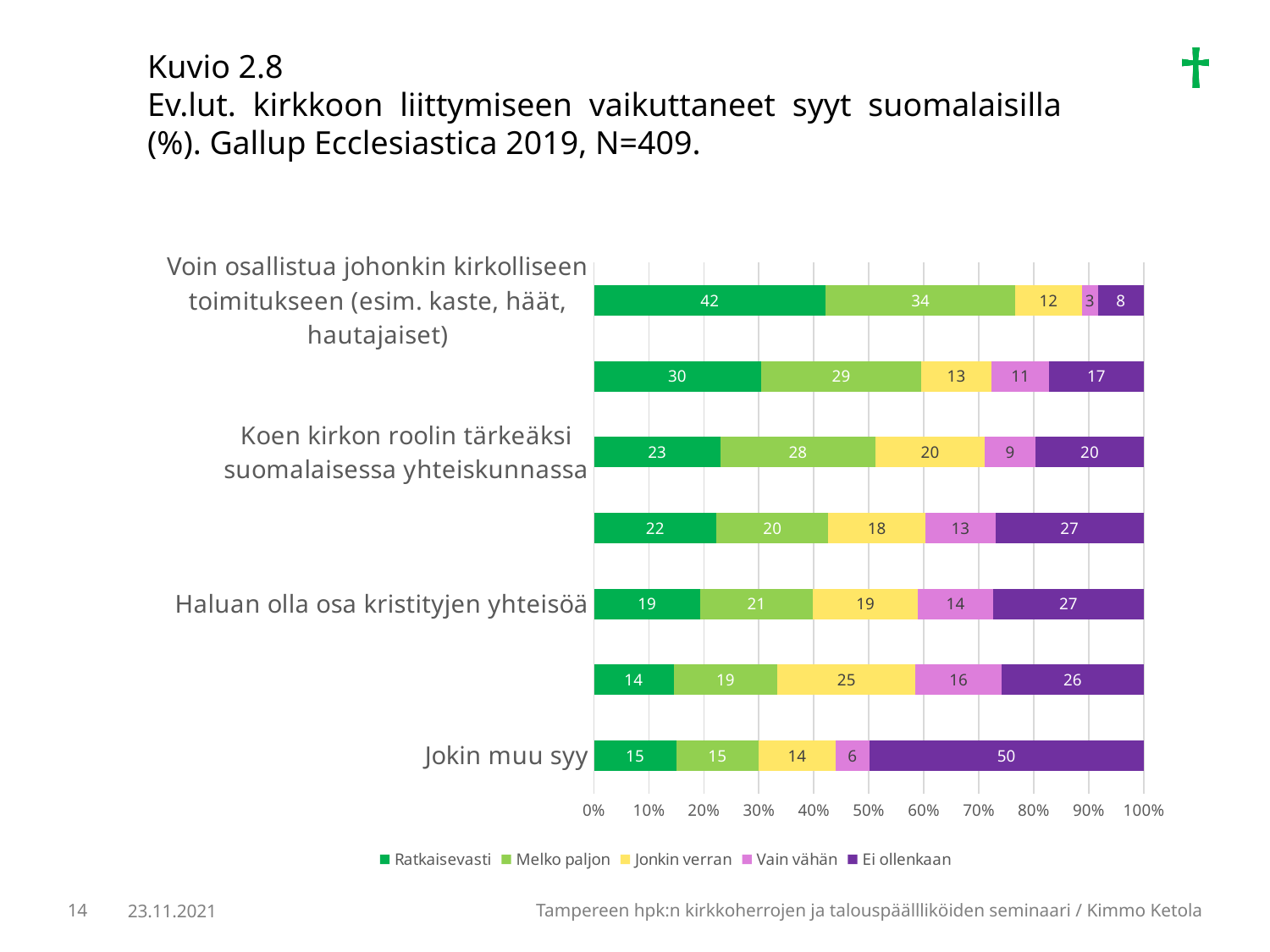
Which has the larger "Melko paljon" value: "Koen kirkon roolin tärkeäksi suomalaisessa yhteiskunnassa" or "Haluan olla osa kristityjen yhteisöä"? Koen kirkon roolin tärkeäksi suomalaisessa yhteiskunnassa Which category has the highest "Ei ollenkaan" value? Jokin muu syy What percentage of respondents answered "Ratkaisevasti" for "Voin osallistua johonkin kirkolliseen toimitukseen (esim. kaste, häät, hautajaiset)"? 42 What is the "Ei ollenkaan" value for "Jokin muu syy"? 50 What is the "Jonkin verran" value for "Koen kirkon roolin tärkeäksi suomalaisessa yhteiskunnassa"? 20 How much larger is the "Ratkaisevasti" value for "Voin osallistua johonkin kirkolliseen toimitukseen" than for "Koen kirkon roolin tärkeäksi suomalaisessa yhteiskunnassa"? 19 What is the "Vain vähän" value for "Haluan olla osa kristityjen yhteisöä"? 14 Which category has the highest "Ratkaisevasti" value? Voin osallistua johonkin kirkolliseen toimitukseen (esim. kaste, häät, hautajaiset) What is the total of the stacked bar for "Jokin muu syy"? 100 How many series does the legend list? 5 What kind of chart is shown on the slide? Stacked bar chart How many bars are plotted in the chart? 7